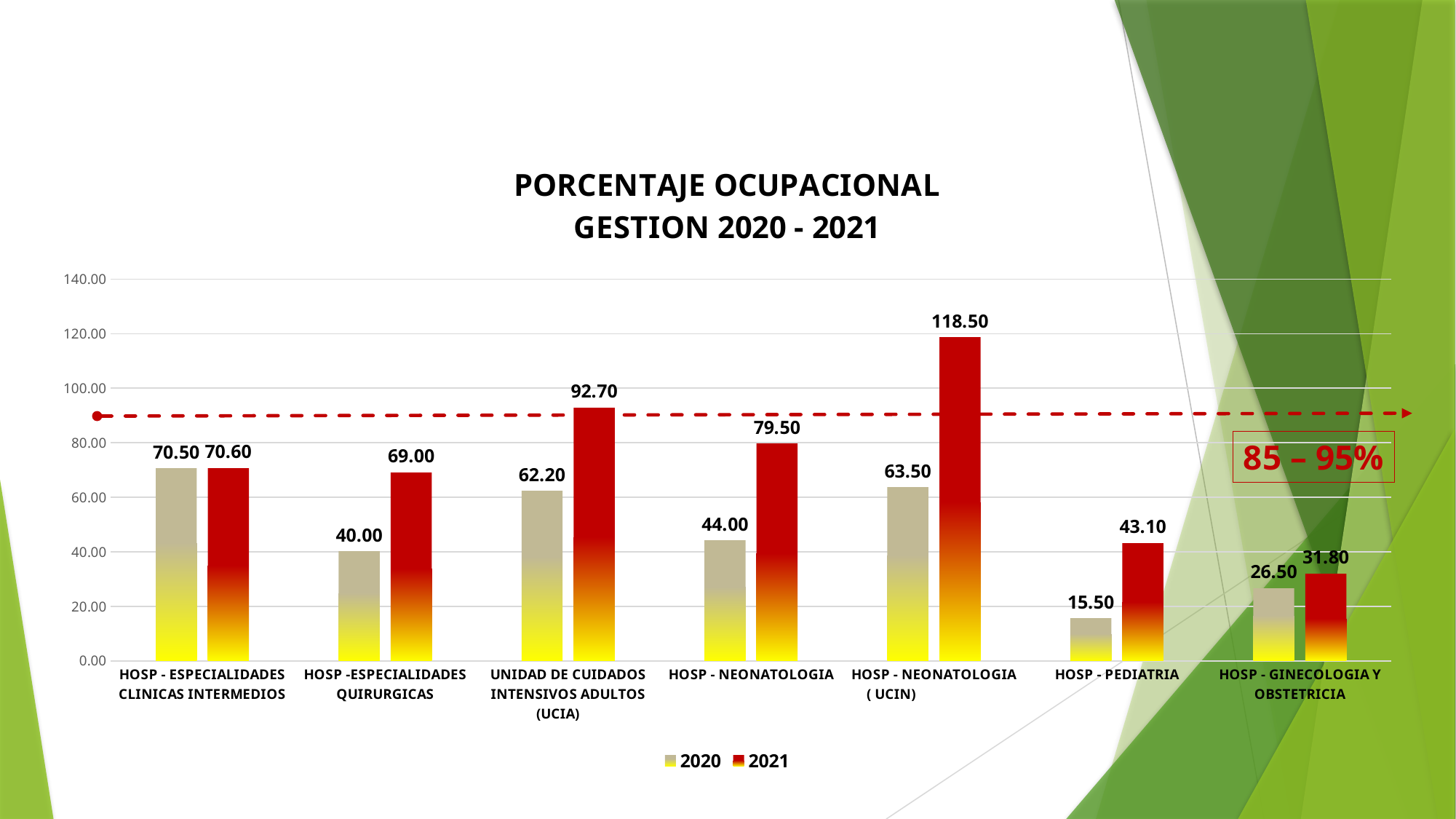
How many categories are shown on the x axis? 7 What is the 2020 value for HOSP - PEDIATRIA? 15.50 What is the difference between the 2021 and 2020 values for HOSP - NEONATOLOGIA? 35.50 Is the 2021 value for HOSP - NEONATOLOGIA ( UCIN) greater or less than 100.00? greater What is the 2021 value for HOSP - NEONATOLOGIA ( UCIN)? 118.50 How many series does the legend list? 2 What is the 2021 value for UNIDAD DE CUIDADOS INTENSIVOS ADULTOS (UCIA)? 92.70 What kind of chart is shown on the slide? bar chart What is the title of the chart? PORCENTAJE OCUPACIONAL GESTION 2020 - 2021 Which category has the highest 2021 value? HOSP - NEONATOLOGIA ( UCIN) Which is larger for HOSP -ESPECIALIDADES QUIRURGICAS, the 2020 value or the 2021 value? 2021 Which category has the lowest 2020 value? HOSP - PEDIATRIA